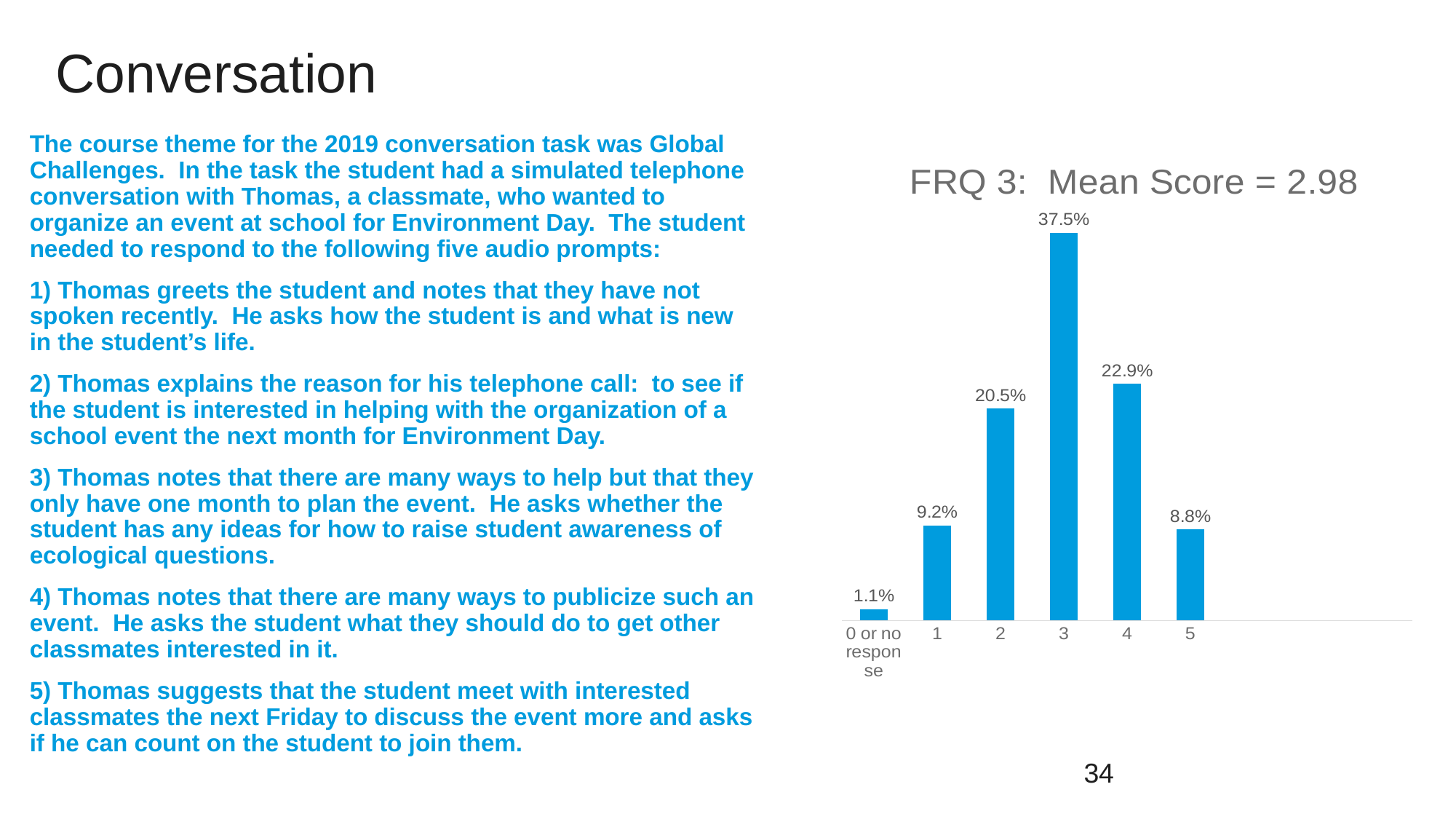
What is the difference between the percentage for score 2 and the percentage for score 5? 11.7% What percentage of students scored 1 on FRQ 3? 9.2% What kind of chart is shown on the slide? bar chart What percentage is shown for the '0 or no response' category? 1.1% Which score category has the highest percentage? 3 How many score categories are shown on the x axis? 6 Which score category has the lowest percentage? 0 or no response Which has a larger percentage, score 4 or score 2? 4 What is the difference between the percentage for score 3 and the percentage for score 4? 14.6% What percentage of students scored 3 on FRQ 3? 37.5% What mean score is stated in the chart title? 2.98 Which has a larger percentage, score 1 or score 5? 1